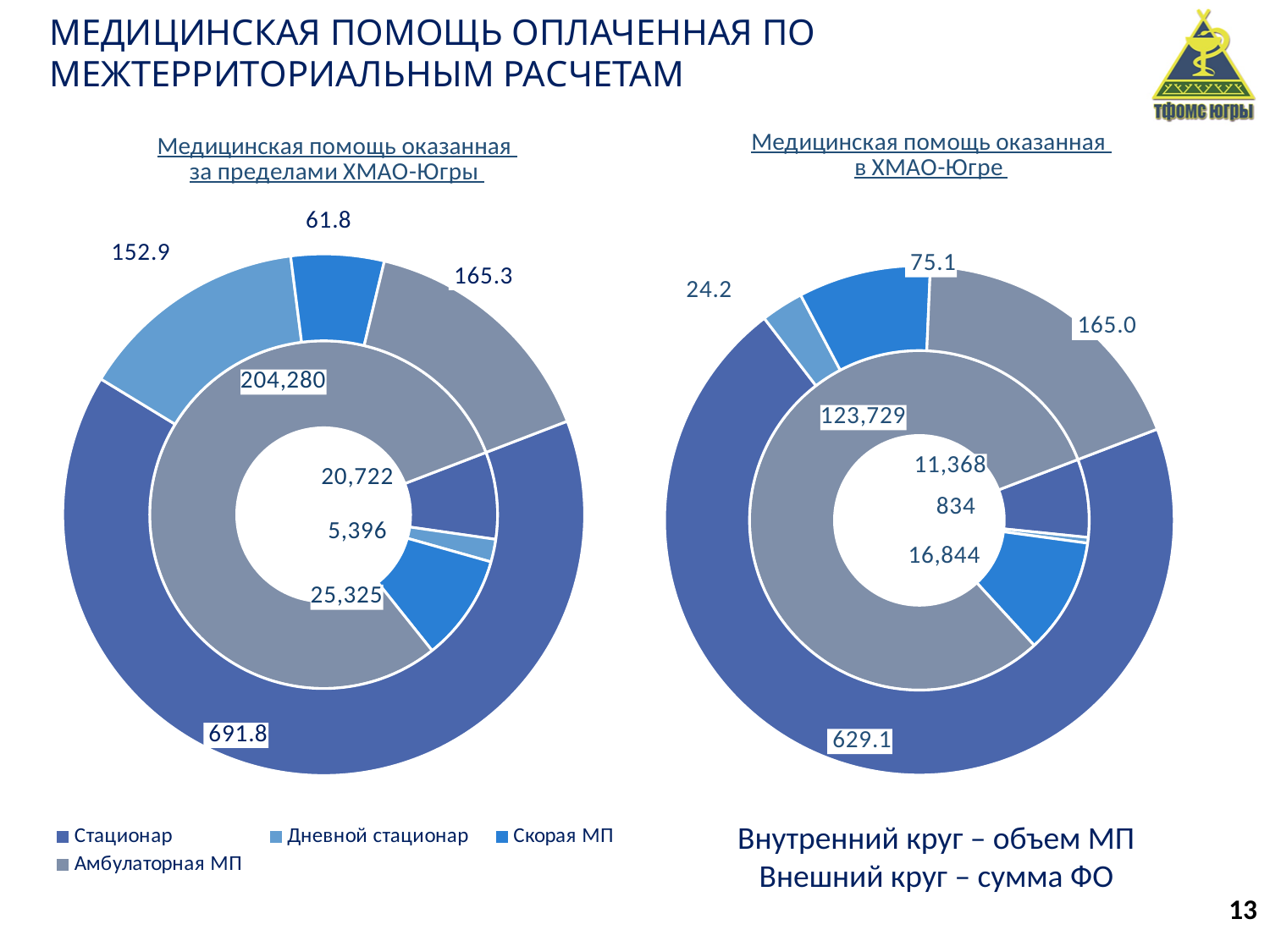
In the chart 'Медицинская помощь оказанная в ХМАО-Югре', what is the outer-ring value (сумма ФО) for Скорая МП? 75.1 In the chart 'Медицинская помощь оказанная за пределами ХМАО-Югры', what is the difference between the outer-ring values for Амбулаторная МП and Дневной стационар? 12.4 In the chart 'Медицинская помощь оказанная в ХМАО-Югре', which category has the smallest inner-ring value (объем МП)? Дневной стационар What type of chart is used on the slide? Doughnut chart In the chart 'Медицинская помощь оказанная за пределами ХМАО-Югры', which category has the largest outer-ring value (сумма ФО)? Стационар In the chart 'Медицинская помощь оказанная в ХМАО-Югре', what is the inner-ring value (объем МП) for Дневной стационар? 834 In the chart 'Медицинская помощь оказанная за пределами ХМАО-Югры', what is the outer-ring value (сумма ФО) for Стационар? 691.8 How many categories does the legend list for the charts on the slide? 4 Which is larger: the outer-ring value for Стационар in the chart 'за пределами ХМАО-Югры' or in the chart 'в ХМАО-Югре'? за пределами ХМАО-Югры (691.8) In the chart 'Медицинская помощь оказанная за пределами ХМАО-Югры', what is the inner-ring value (объем МП) for Амбулаторная МП? 204,280 In the chart 'Медицинская помощь оказанная в ХМАО-Югре', what is the difference between the inner-ring values for Скорая МП and Стационар? 5,476 According to the note on the slide, what does the inner ring of each chart represent? Объем МП